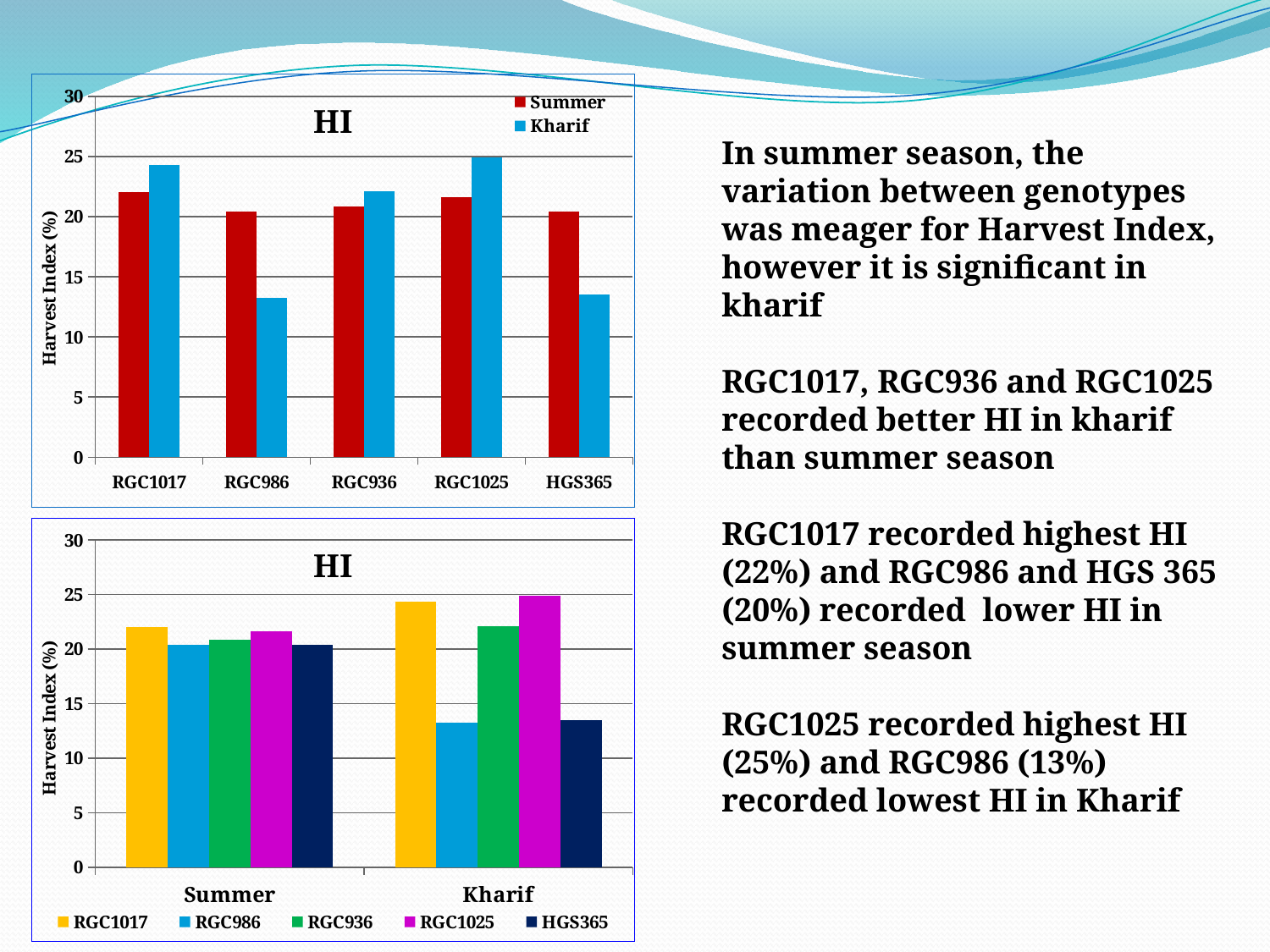
In the bottom chart, which genotype has the highest value for Kharif? RGC1025 In the top chart, which is larger for RGC986: the Summer value or the Kharif value? Summer In the bottom chart, how many categories are shown on the x axis? 2 What is the y-axis label of the top chart? Harvest Index (%) What kind of chart is the top chart on the slide? bar chart In the top chart, is the Kharif value for RGC986 greater or less than 15? less In the top chart, how many genotype categories are shown on the x axis? 5 In the top chart, which is larger for RGC1017: the Summer value or the Kharif value? Kharif In the bottom chart, is the HGS365 value for Kharif greater or less than 15? less In the top chart, how many series does the legend list? 2 In the top chart, is the Kharif value for RGC1025 greater or less than 20? greater In the bottom chart, how many series does the legend list? 5